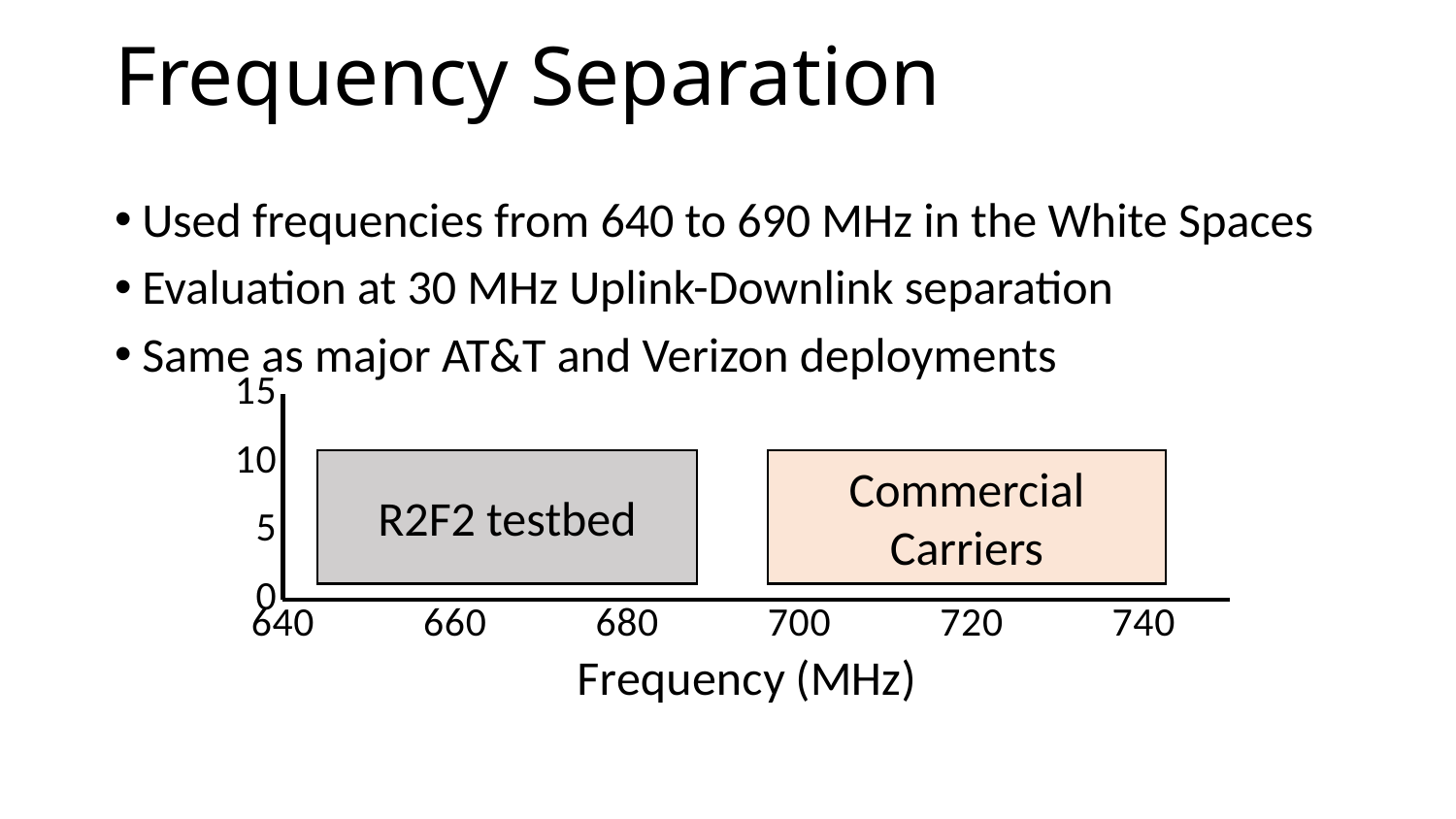
What is the lowest tick value shown on the x axis of the chart? 640 How many labelled regions are drawn on the chart? 2 What is the label on the x axis of the chart? Frequency (MHz) Is the Commercial Carriers region located at frequencies greater or less than 690 MHz? greater What is the highest tick value shown on the y axis of the chart? 15 How many tick labels are shown on the x axis of the chart? 6 Which labelled region on the chart occupies the higher frequencies? Commercial Carriers Is the R2F2 testbed region located at frequencies greater or less than 700 MHz? less What is the highest tick value shown on the x axis of the chart? 740 Which labelled region on the chart occupies the lower frequencies, R2F2 testbed or Commercial Carriers? R2F2 testbed